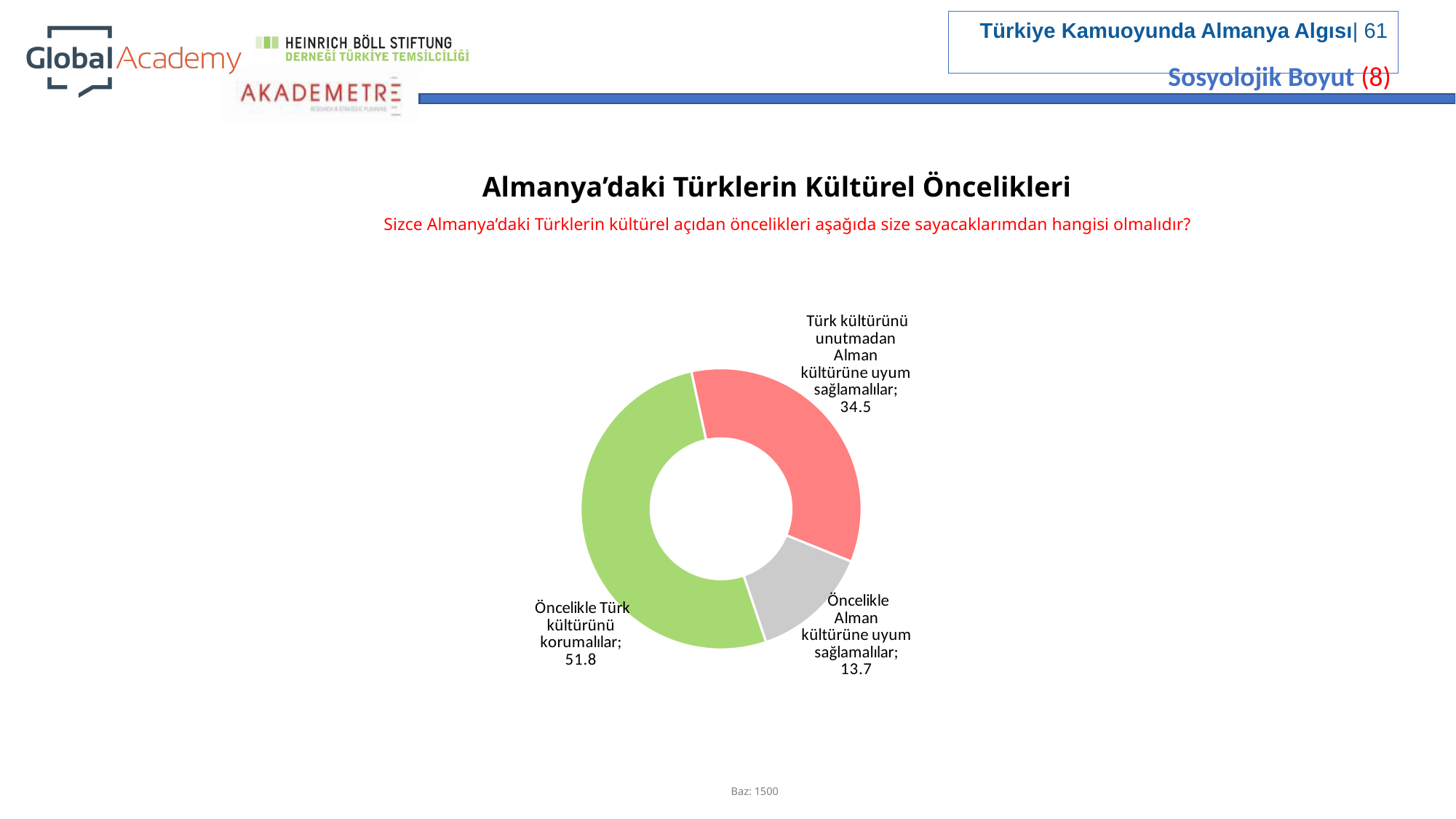
What colour is the slice for "Öncelikle Türk kültürünü korumalılar"? Green What is the difference between the values for "Öncelikle Türk kültürünü korumalılar" and "Türk kültürünü unutmadan Alman kültürüne uyum sağlamalılar"? 17.3 Which is larger: the value for "Türk kültürünü unutmadan Alman kültürüne uyum sağlamalılar" or for "Öncelikle Alman kültürüne uyum sağlamalılar"? Türk kültürünü unutmadan Alman kültürüne uyum sağlamalılar How many categories are shown in the chart? 3 What is the difference between the values for "Türk kültürünü unutmadan Alman kültürüne uyum sağlamalılar" and "Öncelikle Alman kültürüne uyum sağlamalılar"? 20.8 What value is shown for "Türk kültürünü unutmadan Alman kültürüne uyum sağlamalılar"? 34.5 What is the title of the chart? Almanya’daki Türklerin Kültürel Öncelikleri What kind of chart is shown on the slide? Doughnut (pie) chart Which category has the smallest share of the chart? Öncelikle Alman kültürüne uyum sağlamalılar What value is shown for "Öncelikle Alman kültürüne uyum sağlamalılar"? 13.7 What value is shown for "Öncelikle Türk kültürünü korumalılar"? 51.8 Which category has the largest share of the chart? Öncelikle Türk kültürünü korumalılar